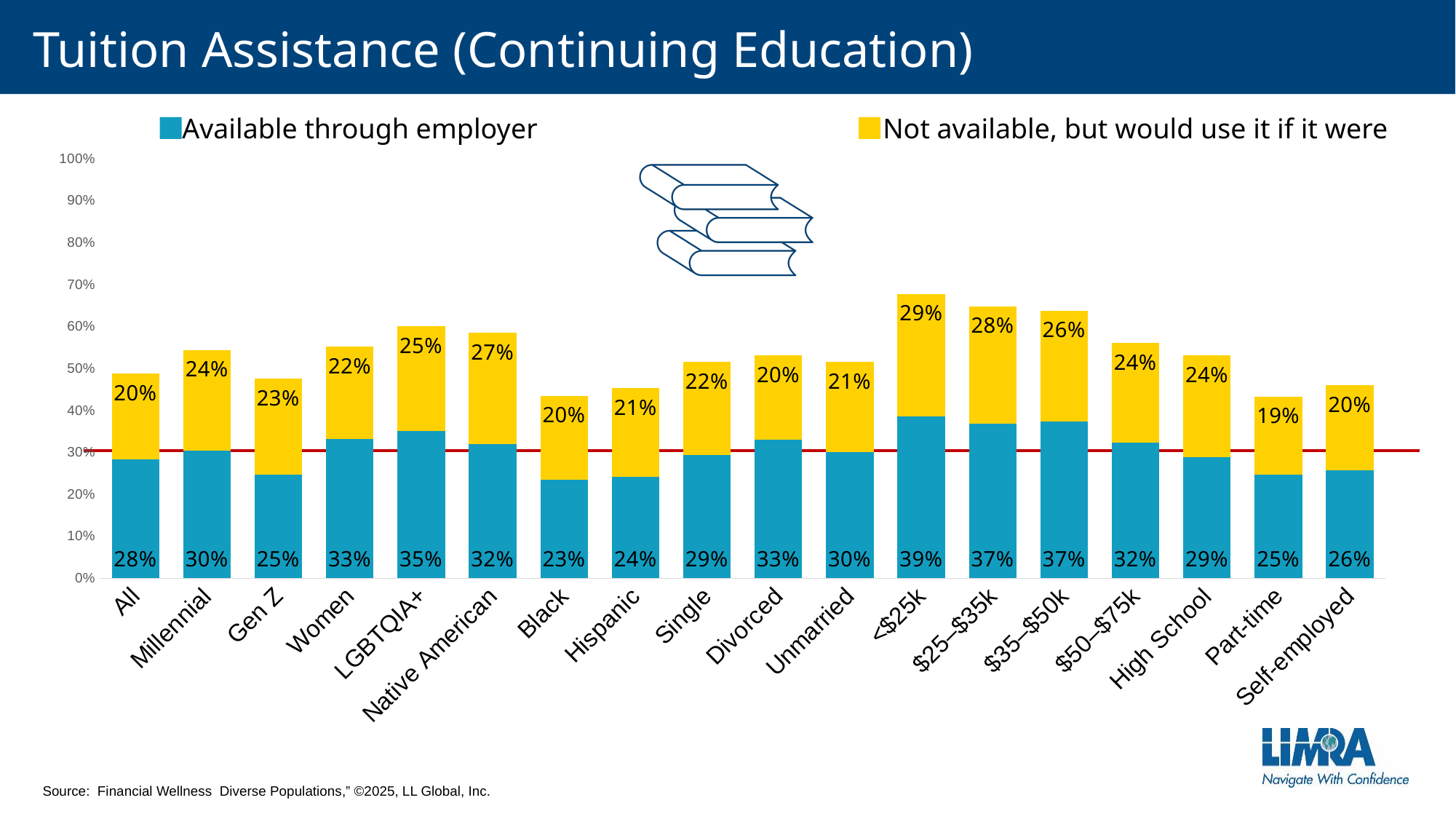
Which category has the lowest 'Available through employer' value? Black What type of chart is shown on the slide? Stacked bar chart How many categories are shown on the x axis? 18 What is the combined total of the two segments for the Black bar? 43% Which has a larger 'Available through employer' value, Millennial or Hispanic? Millennial Which category has the lowest 'Not available, but would use it if it were' value? Part-time What is the 'Not available, but would use it if it were' value for Native American? 27% What percentage of Women have tuition assistance available through their employer? 33% What is the difference between the 'Available through employer' values for LGBTQIA+ and Gen Z? 10% How many series does the legend list? 2 Which category has the highest 'Available through employer' value? <$25k What is the combined total of the two segments for the <$25k bar? 68%